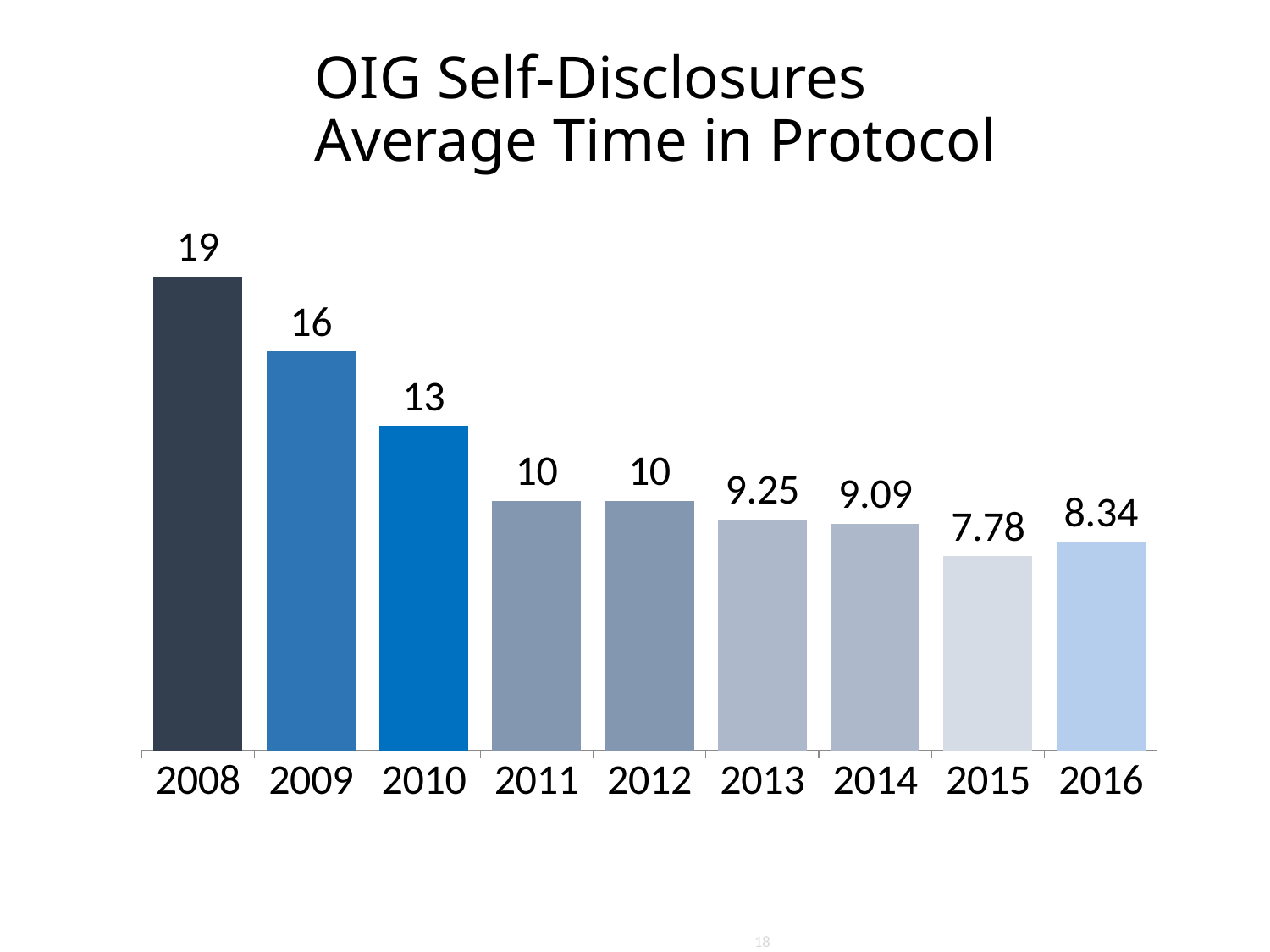
Which is larger, the value for 2010 or the value for 2016? 2010 What is the value for 2016? 8.34 What is the value for 2015? 7.78 Do the values generally rise or fall from 2008 to 2015? Fall What kind of chart is shown on the slide? Bar chart What is the value for 2008? 19 Which year has the lowest value? 2015 What is the difference between the values for 2008 and 2009? 3 What is the value for 2013? 9.25 Which year has the highest value? 2008 What is the difference between the values for 2014 and 2015? 1.31 How many years are shown on the x axis? 9